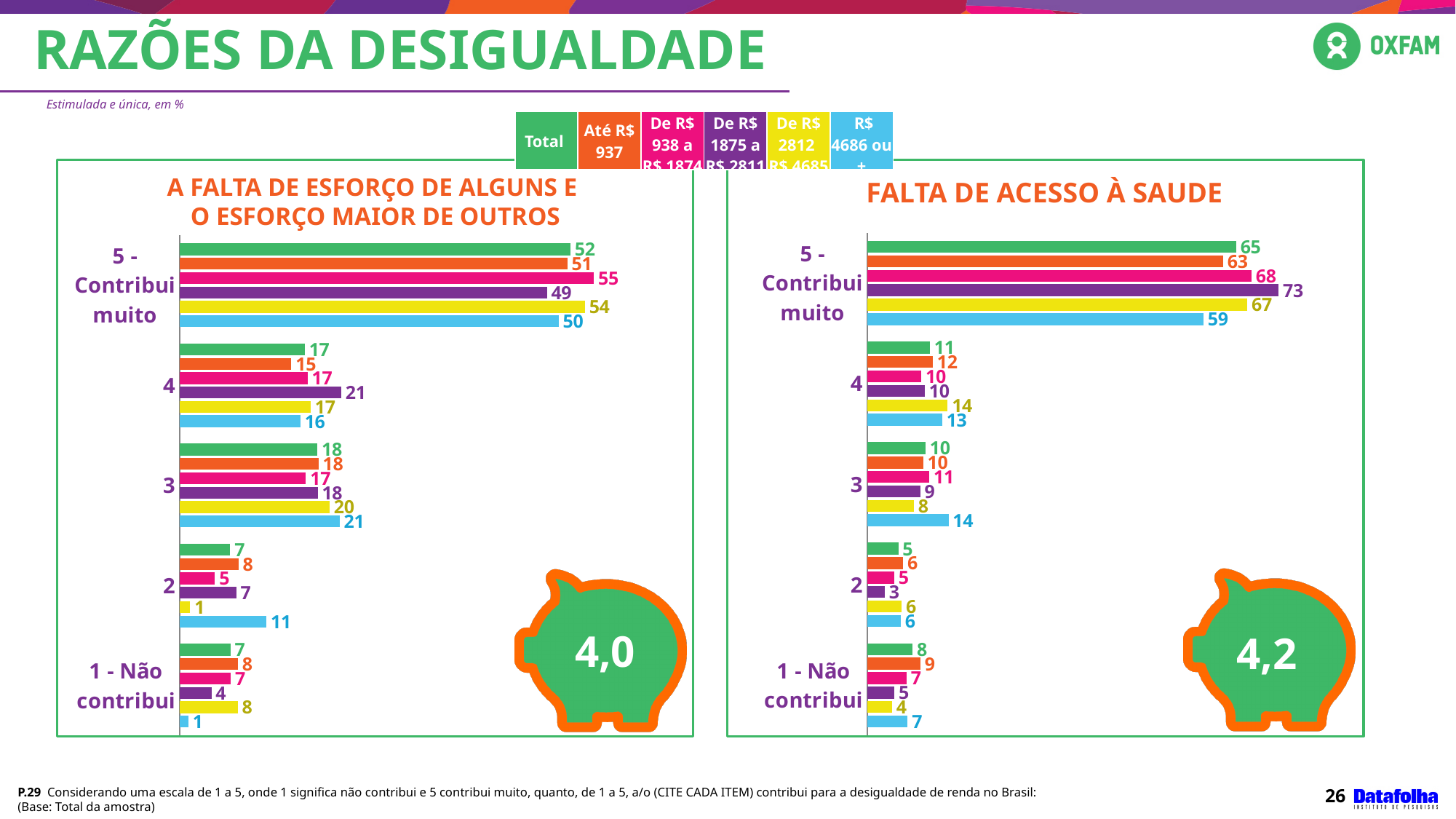
In the chart 'FALTA DE ACESSO À SAUDE', what is the value for 'De R$ 1875 a R$ 2811' at '5 - Contribui muito'? 73 In the chart 'A FALTA DE ESFORÇO DE ALGUNS E O ESFORÇO MAIOR DE OUTROS', which is larger at '2': the value for 'Até R$ 937' or for 'R$ 4686 ou +'? R$ 4686 ou + How many series does the legend list for the charts on this slide? 6 How many scale categories are shown on the y axis of the chart 'FALTA DE ACESSO À SAUDE'? 5 What average score is shown inside the piggy bank icon on the chart 'FALTA DE ACESSO À SAUDE'? 4,2 In the chart 'FALTA DE ACESSO À SAUDE', which income group has the highest value for '5 - Contribui muito'? De R$ 1875 a R$ 2811 In the chart 'A FALTA DE ESFORÇO DE ALGUNS E O ESFORÇO MAIOR DE OUTROS', what is the value for 'De R$ 2812 a R$ 4685' at '2'? 1 What kind of chart is 'A FALTA DE ESFORÇO DE ALGUNS E O ESFORÇO MAIOR DE OUTROS'? Bar chart In the chart 'FALTA DE ACESSO À SAUDE', what is the value for 'R$ 4686 ou +' at '3'? 14 In the chart 'FALTA DE ACESSO À SAUDE', what is the difference between the Total values for '5 - Contribui muito' and '4'? 54 In the chart 'A FALTA DE ESFORÇO DE ALGUNS E O ESFORÇO MAIOR DE OUTROS', what is the Total value for '5 - Contribui muito'? 52 In the chart 'A FALTA DE ESFORÇO DE ALGUNS E O ESFORÇO MAIOR DE OUTROS', which income group has the lowest value for '1 - Não contribui'? R$ 4686 ou +